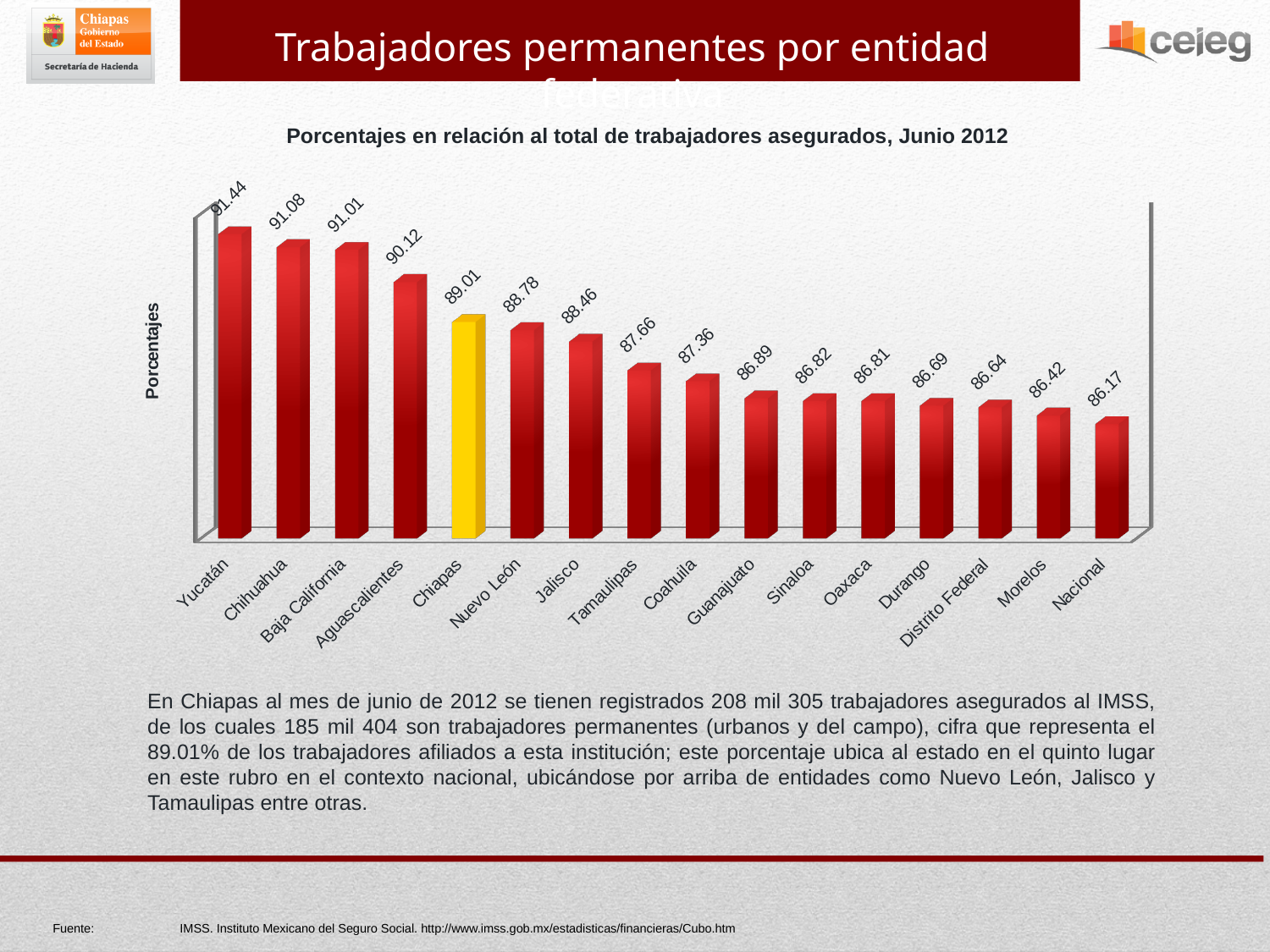
Which has a larger value, Aguascalientes or Jalisco? Aguascalientes Which category has the highest value? Yucatán What is the value shown for Yucatán? 91.44 Which category has the lowest value? Nacional What is the value shown for Chiapas? 89.01 How many categories are shown on the x axis? 16 What is the difference between the values for Yucatán and Nacional? 5.27 What is the value shown for Distrito Federal? 86.64 What kind of chart is shown? Bar chart What is the difference between the values for Chiapas and Nuevo León? 0.23 What is the value shown for Nacional? 86.17 Which bar is coloured yellow instead of red? Chiapas